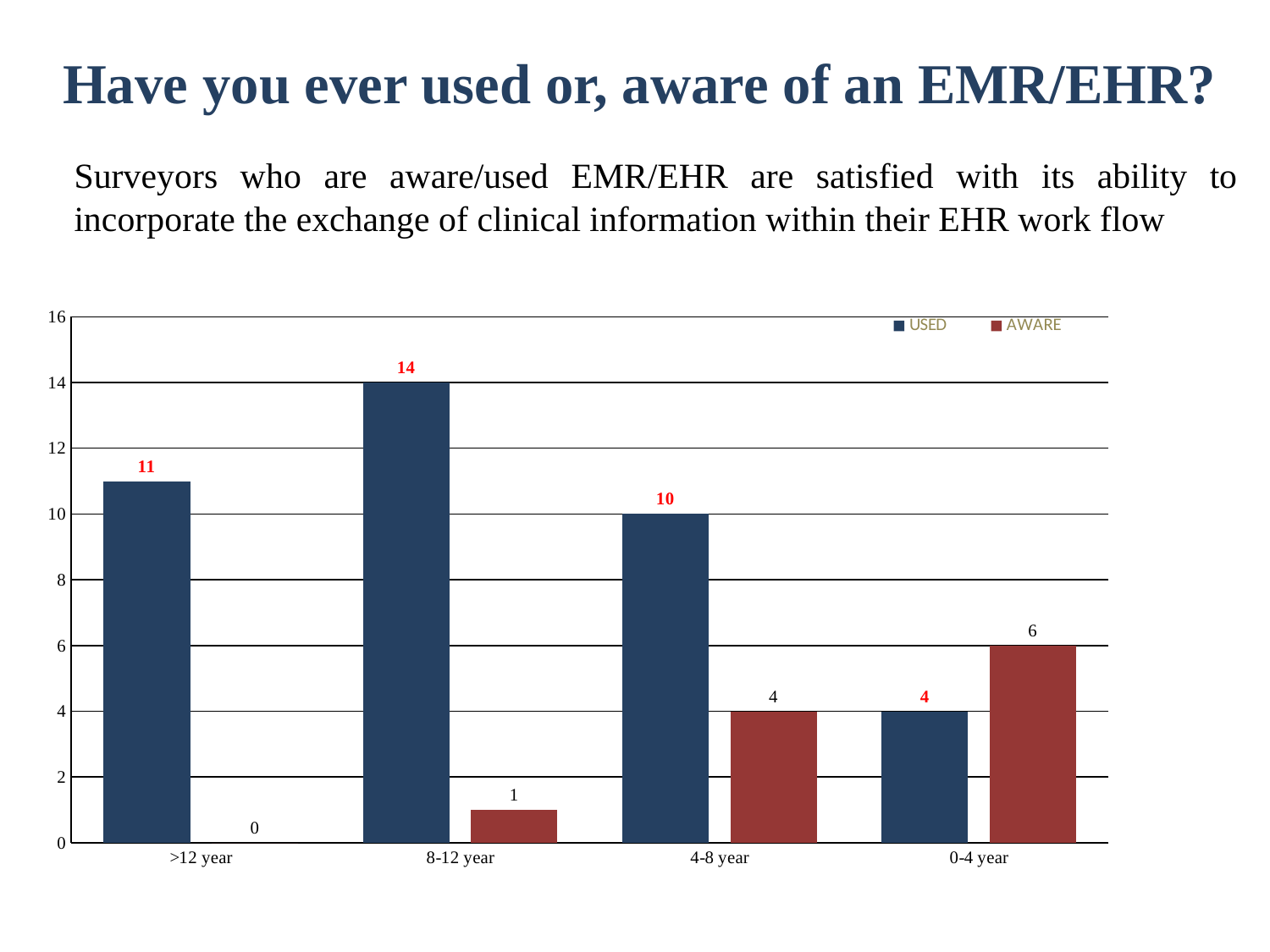
Which category has the lowest AWARE value? >12 year What is the difference between the USED and AWARE values for the 8-12 year category? 13 What is the USED value for the 4-8 year category? 10 What is the AWARE value for the 0-4 year category? 6 For the 0-4 year category, which is larger, USED or AWARE? AWARE What is the total of the USED values across all four categories? 39 How many categories are shown on the x axis? 4 Which category has the highest USED value? 8-12 year What is the USED value for the 8-12 year category? 14 What is the AWARE value for the >12 year category? 0 What kind of chart is shown on the slide? bar chart How many series does the legend list? 2